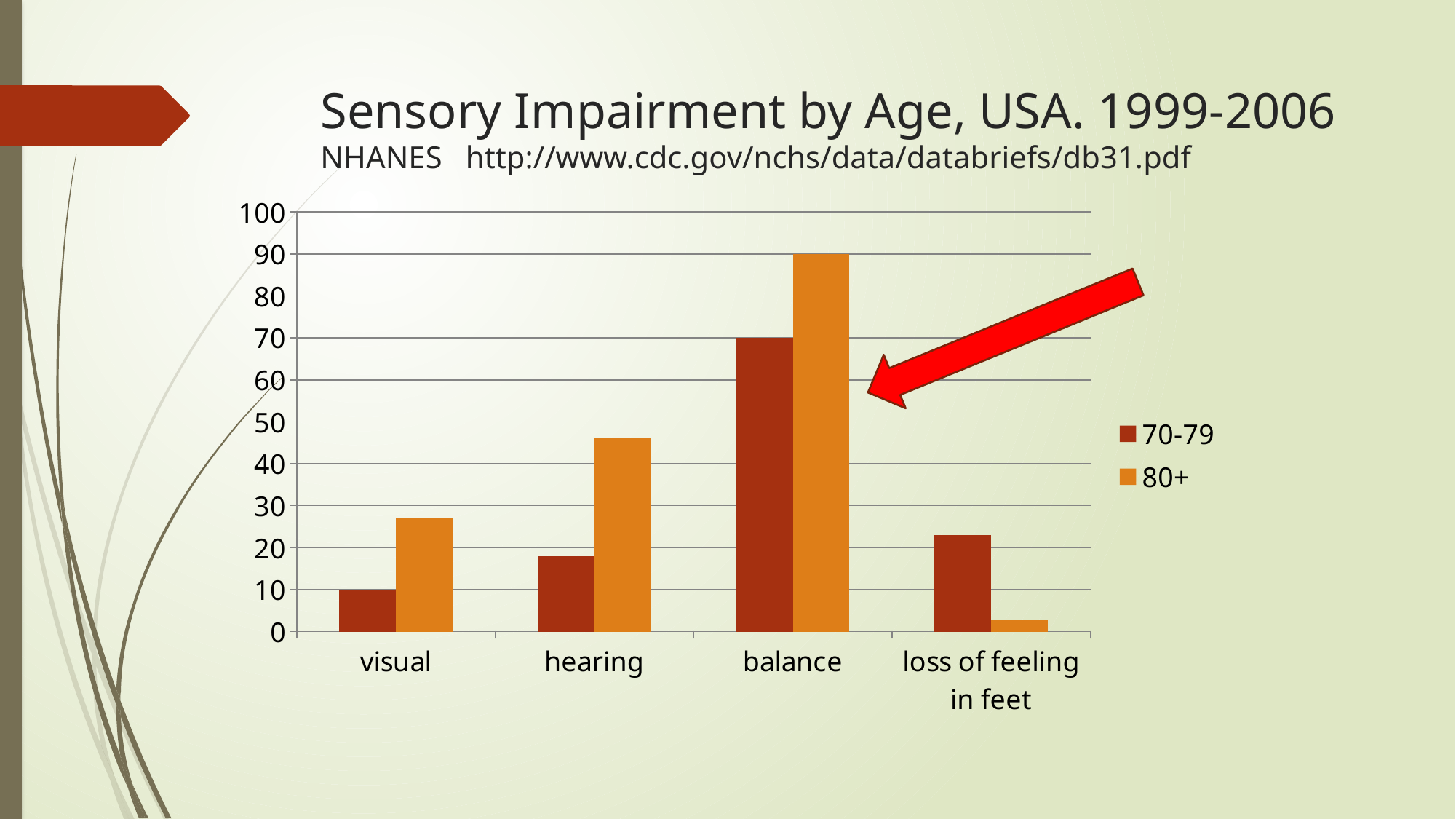
Is the value for loss of feeling in feet in the 80+ series greater or less than 10? less For loss of feeling in feet, which series has the larger value, 70-79 or 80+? 70-79 What type of chart is shown on the slide? bar chart Which category has the highest value in the 80+ series? balance What is the value for balance in the 70-79 series? 70 Is the value for hearing in the 80+ series greater or less than 40? greater How many categories are shown on the x axis? 4 What is the difference between the 80+ and 70-79 values for balance? 20 What is the value for balance in the 80+ series? 90 What is the value for visual in the 70-79 series? 10 Which category has the lowest value in the 80+ series? loss of feeling in feet How many series does the legend list? 2